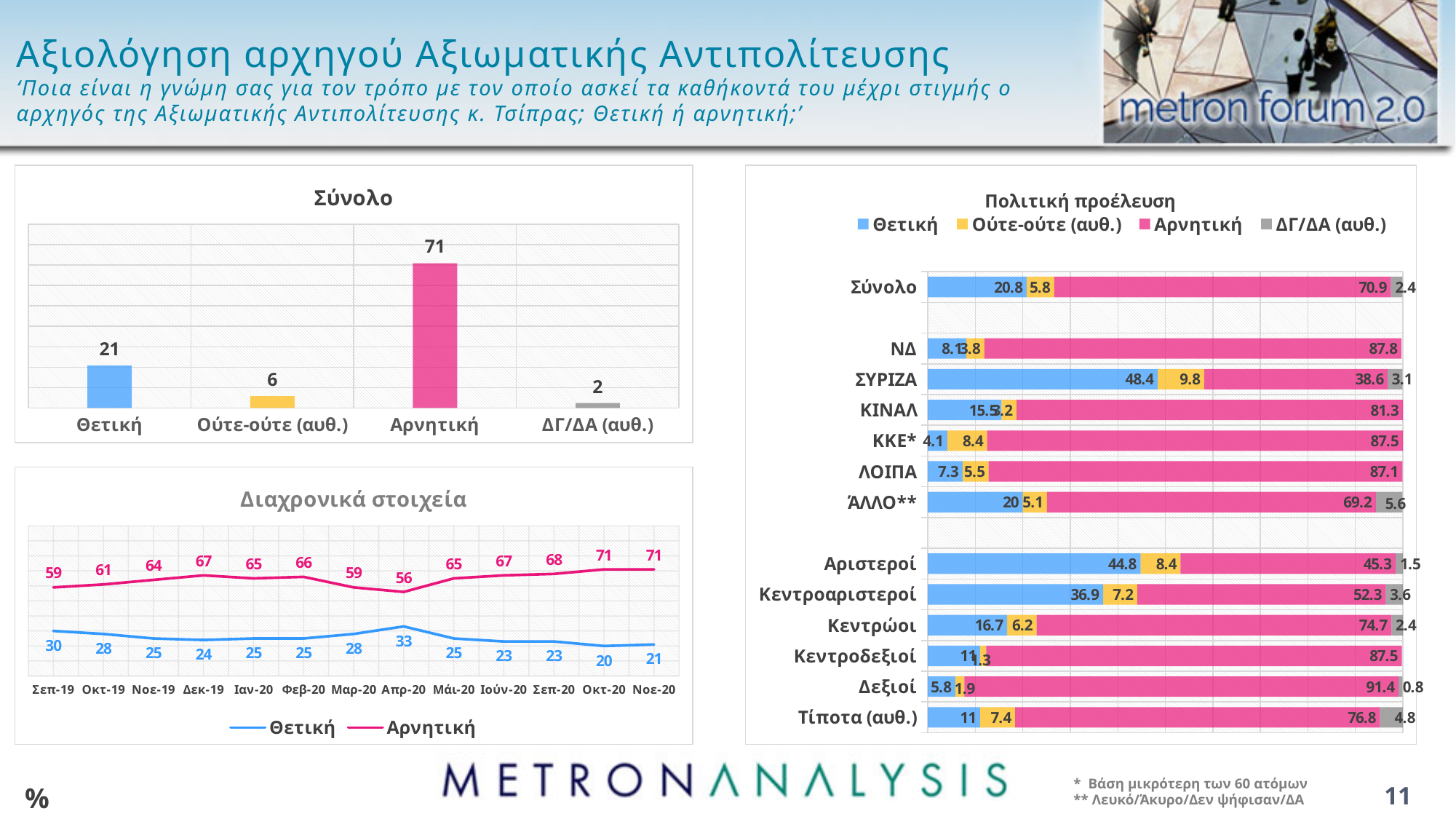
In the 'Πολιτική προέλευση' chart, which category has the highest Θετική value? ΣΥΡΙΖΑ In the 'Σύνολο' chart, which category has the lowest value? ΔΓ/ΔΑ (αυθ.) What kind of chart is the 'Σύνολο' chart? bar chart In the 'Διαχρονικά στοιχεία' chart, does the Αρνητική series rise or fall from Απρ-20 to Νοε-20? rise In the 'Πολιτική προέλευση' chart, how many series does the legend list? 4 In the 'Σύνολο' chart, what is the value for Αρνητική? 71 In the 'Πολιτική προέλευση' chart, what is the Αρνητική value for Δεξιοί? 91.4 In the 'Σύνολο' chart, what is the difference between Αρνητική and Θετική? 50 In the 'Διαχρονικά στοιχεία' chart, how many series does the legend list? 2 In the 'Διαχρονικά στοιχεία' chart, what is the Θετική value for Απρ-20? 33 In the 'Διαχρονικά στοιχεία' chart, what is the Αρνητική value for Σεπ-19? 59 In the 'Διαχρονικά στοιχεία' chart, how many time points are shown on the x axis? 13